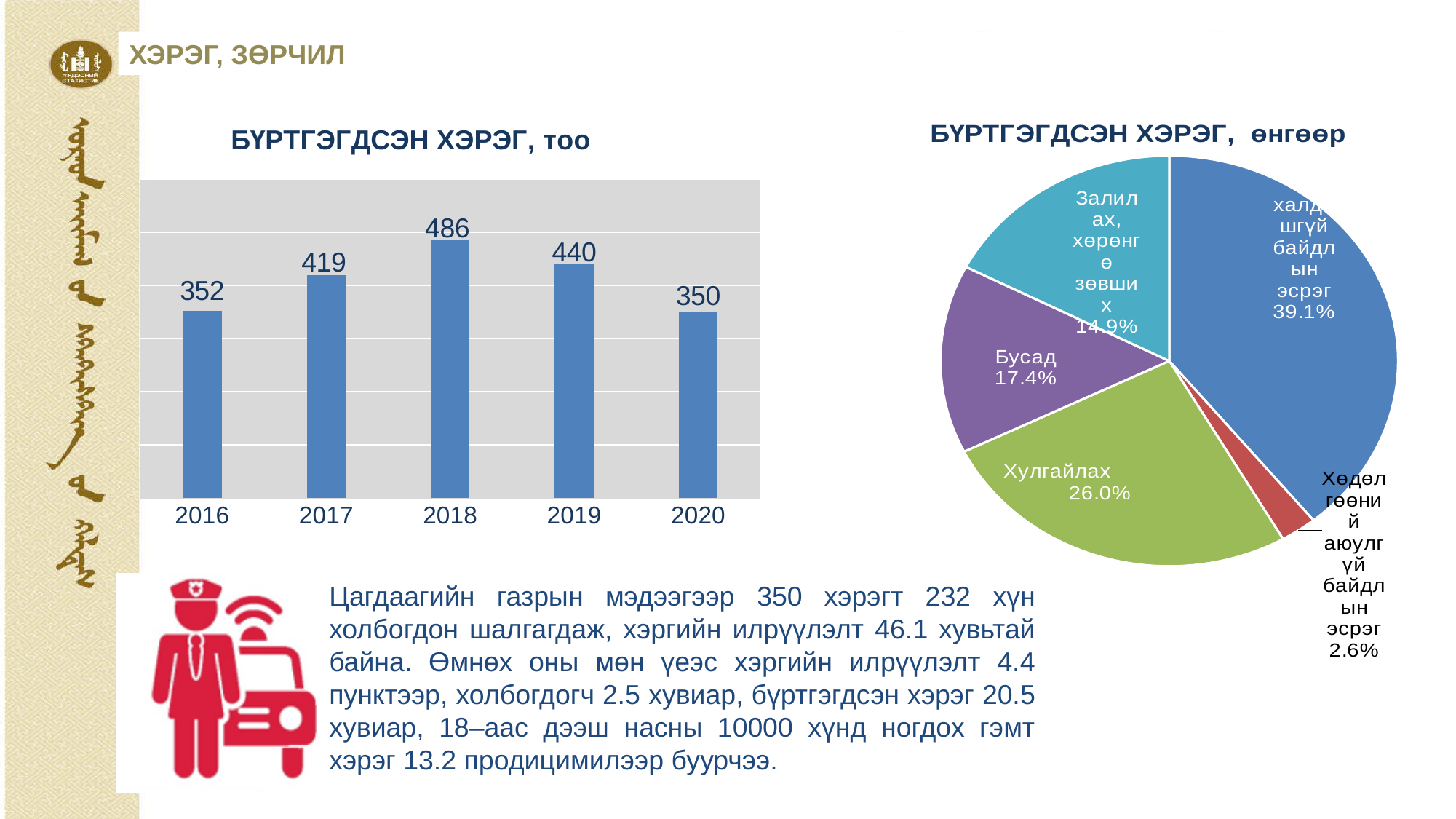
In the pie chart 'БҮРТГЭГДСЭН ХЭРЭГ, өнгөөр', which category has the smallest share? Хөдөлгөөний аюулгүй байдлын эсрэг In the bar chart 'БҮРТГЭГДСЭН ХЭРЭГ, тоо', do the values rise or fall from 2018 to 2020? Fall In the bar chart 'БҮРТГЭГДСЭН ХЭРЭГ, тоо', what is the value for 2020? 350 In the pie chart 'БҮРТГЭГДСЭН ХЭРЭГ, өнгөөр', what share does 'Хулгайлах' have? 26.0% In the bar chart 'БҮРТГЭГДСЭН ХЭРЭГ, тоо', what is the difference between the values for 2018 and 2019? 46 In the pie chart 'БҮРТГЭГДСЭН ХЭРЭГ, өнгөөр', what is the difference between the shares of 'Бусад' and 'Залилах, хөрөнгө зөвших'? 2.5% In the bar chart 'БҮРТГЭГДСЭН ХЭРЭГ, тоо', how many years are shown? 5 In the bar chart 'БҮРТГЭГДСЭН ХЭРЭГ, тоо', which year has the highest value? 2018 In the bar chart 'БҮРТГЭГДСЭН ХЭРЭГ, тоо', which is larger, the value for 2017 or the value for 2019? 2019 In the bar chart 'БҮРТГЭГДСЭН ХЭРЭГ, тоо', which year has the lowest value? 2020 In the bar chart 'БҮРТГЭГДСЭН ХЭРЭГ, тоо', what is the value for 2018? 486 What kind of chart is 'БҮРТГЭГДСЭН ХЭРЭГ, тоо'? Bar chart